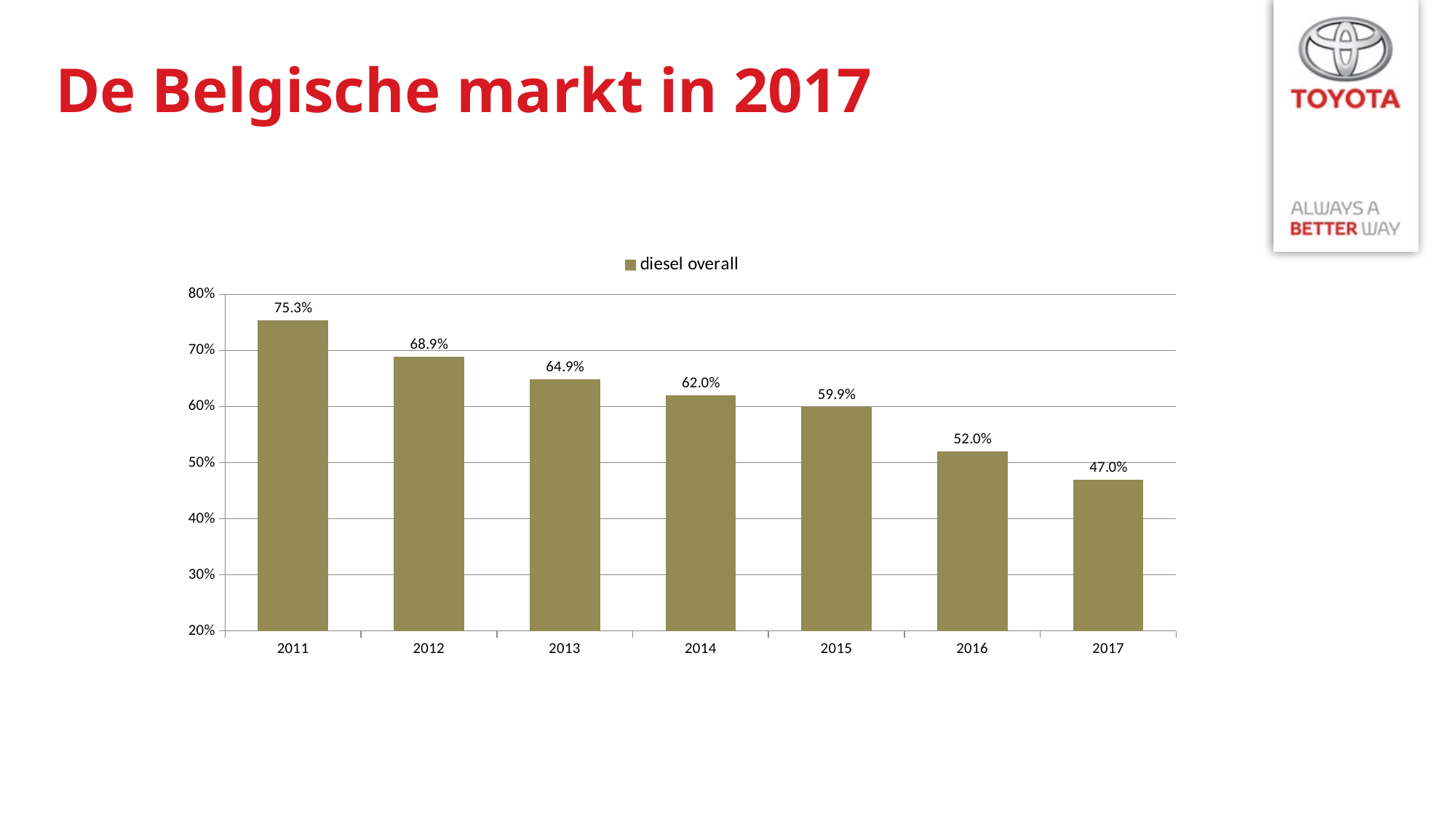
What is the difference between the diesel overall values for 2011 and 2017? 28.3% Do the diesel overall values rise or fall from 2011 to 2017? fall What is the diesel overall value for 2011? 75.3% Which year has a larger diesel overall value, 2013 or 2016? 2013 How many years are shown on the x axis of the chart? 7 Is the diesel overall value for 2016 greater or less than 60%? less What is the diesel overall value for 2014? 62.0% What kind of chart is shown on the slide? bar chart What is the diesel overall value for 2017? 47.0% Which year has the highest diesel overall value? 2011 What is the difference between the diesel overall values for 2015 and 2016? 7.9% Which year has the lowest diesel overall value? 2017